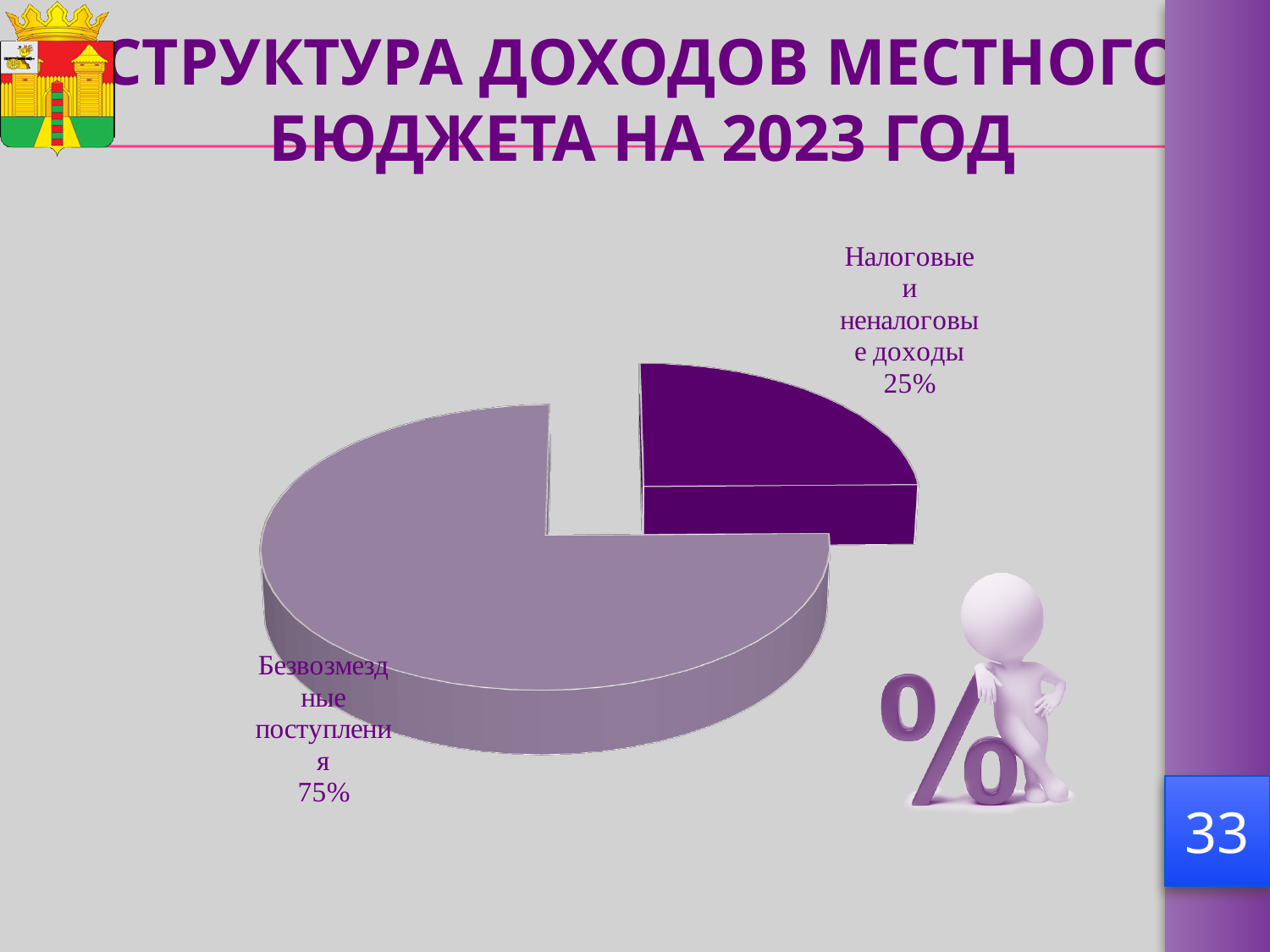
Which slice of the pie is the largest? Безвозмездные поступления How many slices does the pie chart have? 2 What share of the pie does "Безвозмездные поступления" have? 75% Which slice is shown in dark purple? Налоговые и неналоговые доходы What share of the pie does "Налоговые и неналоговые доходы" have? 25% What is the title of the slide containing the chart? СТРУКТУРА ДОХОДОВ МЕСТНОГО БЮДЖЕТА НА 2023 ГОД Which is larger: the share for "Налоговые и неналоговые доходы" or the share for "Безвозмездные поступления"? Безвозмездные поступления What is the difference in percentage points between "Безвозмездные поступления" and "Налоговые и неналоговые доходы"? 50 What kind of chart is shown on the slide? pie chart Which slice of the pie is the smallest? Налоговые и неналоговые доходы